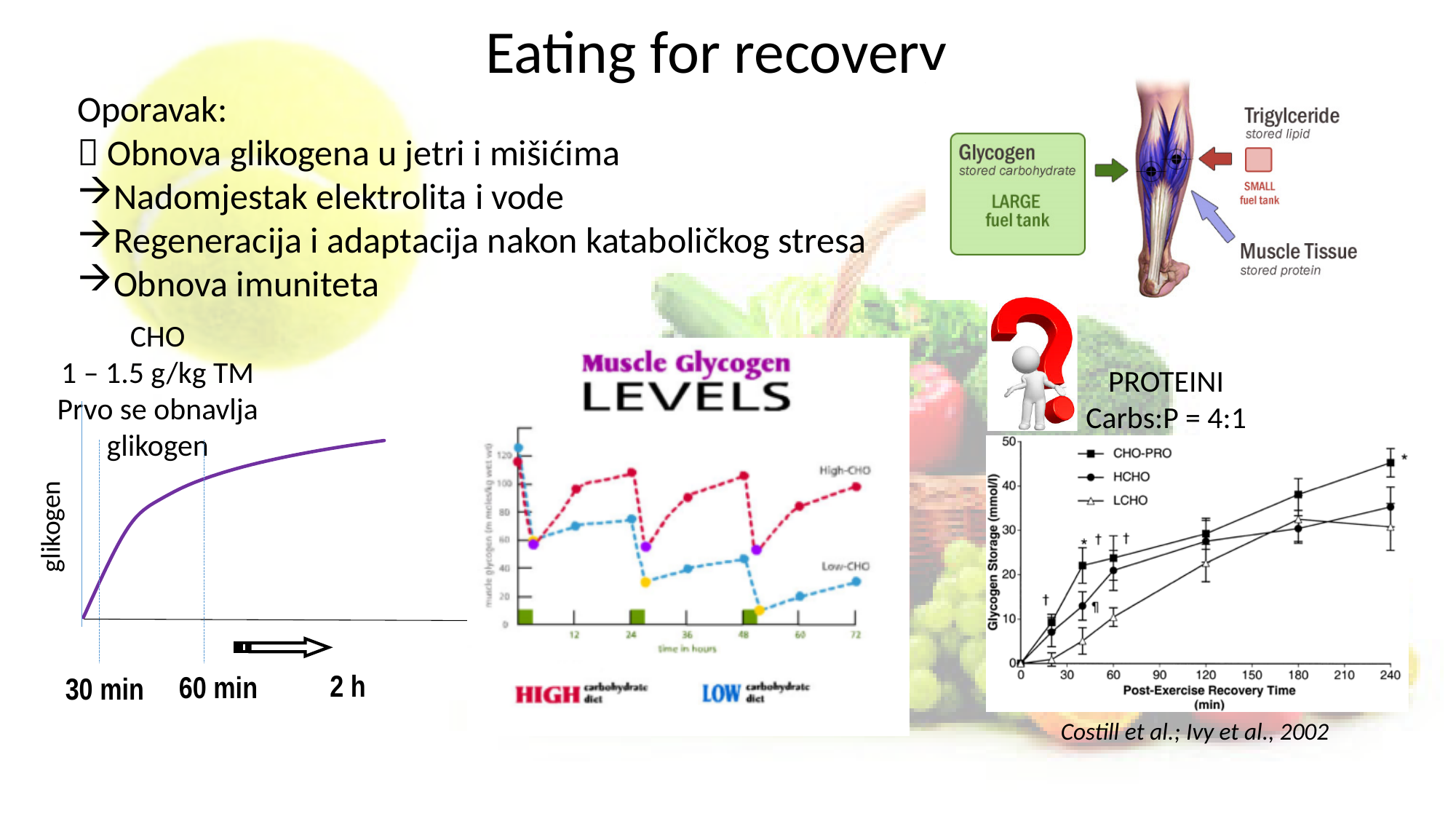
In the Glycogen Storage chart on the right, is the CHO-PRO value at 240 min greater or less than 40? greater What is the x-axis label of the Muscle Glycogen Levels chart in the middle of the slide? time in hours In the Glycogen Storage chart on the right, is the LCHO value at 40 min greater or less than 10? less In the Glycogen Storage chart on the right, does the CHO-PRO series rise or fall as recovery time increases? rise In the Muscle Glycogen Levels chart, is the Low-CHO value at 72 hours greater or less than 40? less How many series does the legend of the Glycogen Storage chart on the right list? 3 What are the legend entries of the Glycogen Storage chart on the right? CHO-PRO, HCHO, LCHO In the Muscle Glycogen Levels chart, which series is higher at 72 hours: High-CHO or Low-CHO? High-CHO In the Glycogen Storage chart on the right, which series has the highest value at 240 min? CHO-PRO What kind of chart is the Glycogen Storage chart on the right of the slide? line chart In the Glycogen Storage chart on the right, which is larger at 60 min: CHO-PRO or LCHO? CHO-PRO How many series are plotted in the Muscle Glycogen Levels chart in the middle of the slide? 2